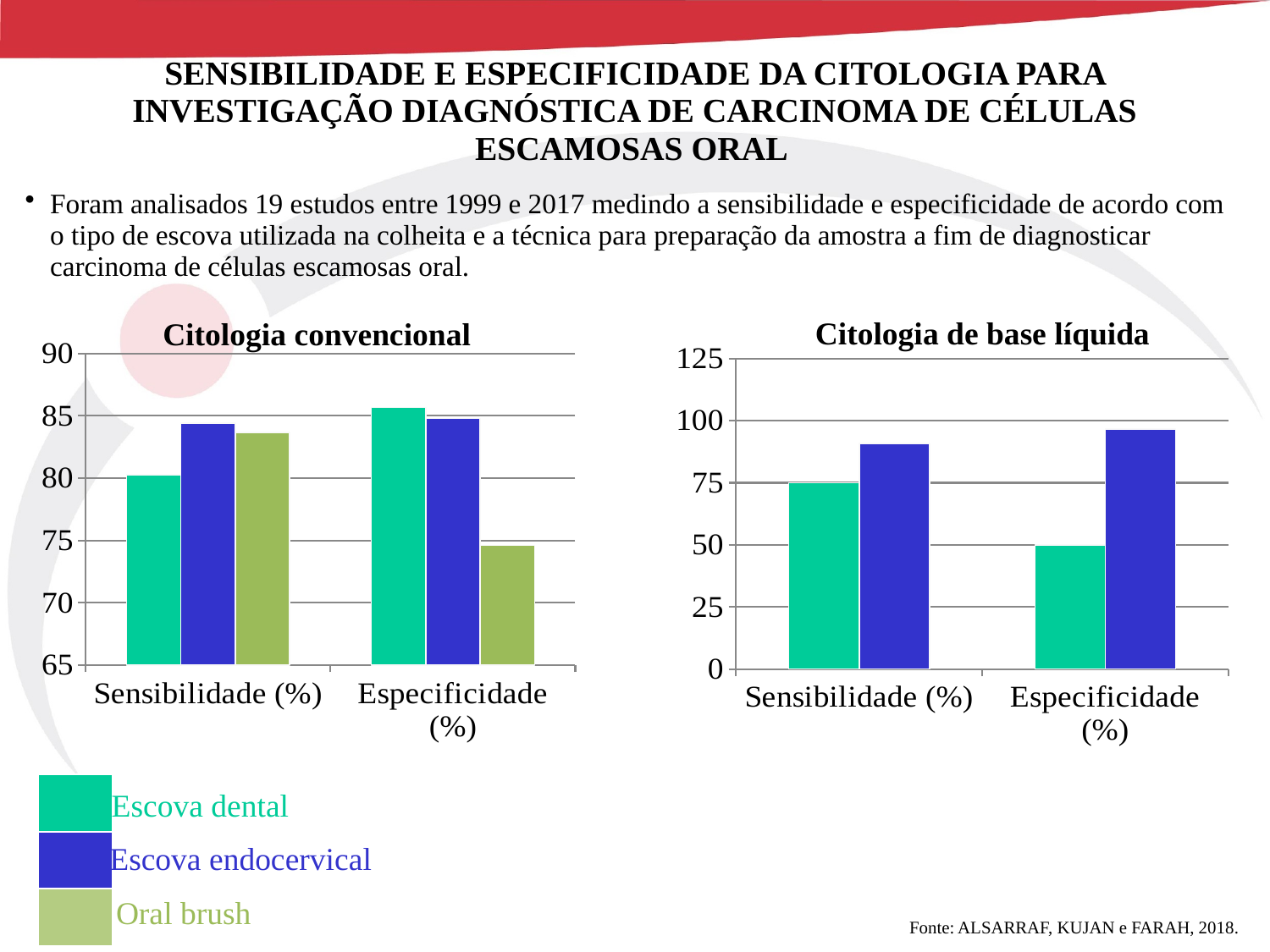
In the "Citologia convencional" chart, is the Sensibilidade (%) value for Escova endocervical greater or less than 80? greater In the "Citologia de base líquida" chart, is the Sensibilidade (%) value for Escova endocervical greater or less than 75? greater How many series does the legend at the bottom of the slide list? 3 In the "Citologia convencional" chart, is the Especificidade (%) value for Oral brush greater or less than 80? less In the "Citologia de base líquida" chart, which series has the highest value for Especificidade (%)? Escova endocervical In the "Citologia de base líquida" chart, which is larger for Sensibilidade (%): Escova dental or Escova endocervical? Escova endocervical What kind of chart is the "Citologia convencional" chart? bar chart What is the title of the chart on the right side of the slide? Citologia de base líquida In the "Citologia convencional" chart, which series has the lowest value for Especificidade (%)? Oral brush How many categories are shown on the x axis of the "Citologia de base líquida" chart? 2 In the "Citologia convencional" chart, which is larger for Especificidade (%): Escova dental or Oral brush? Escova dental